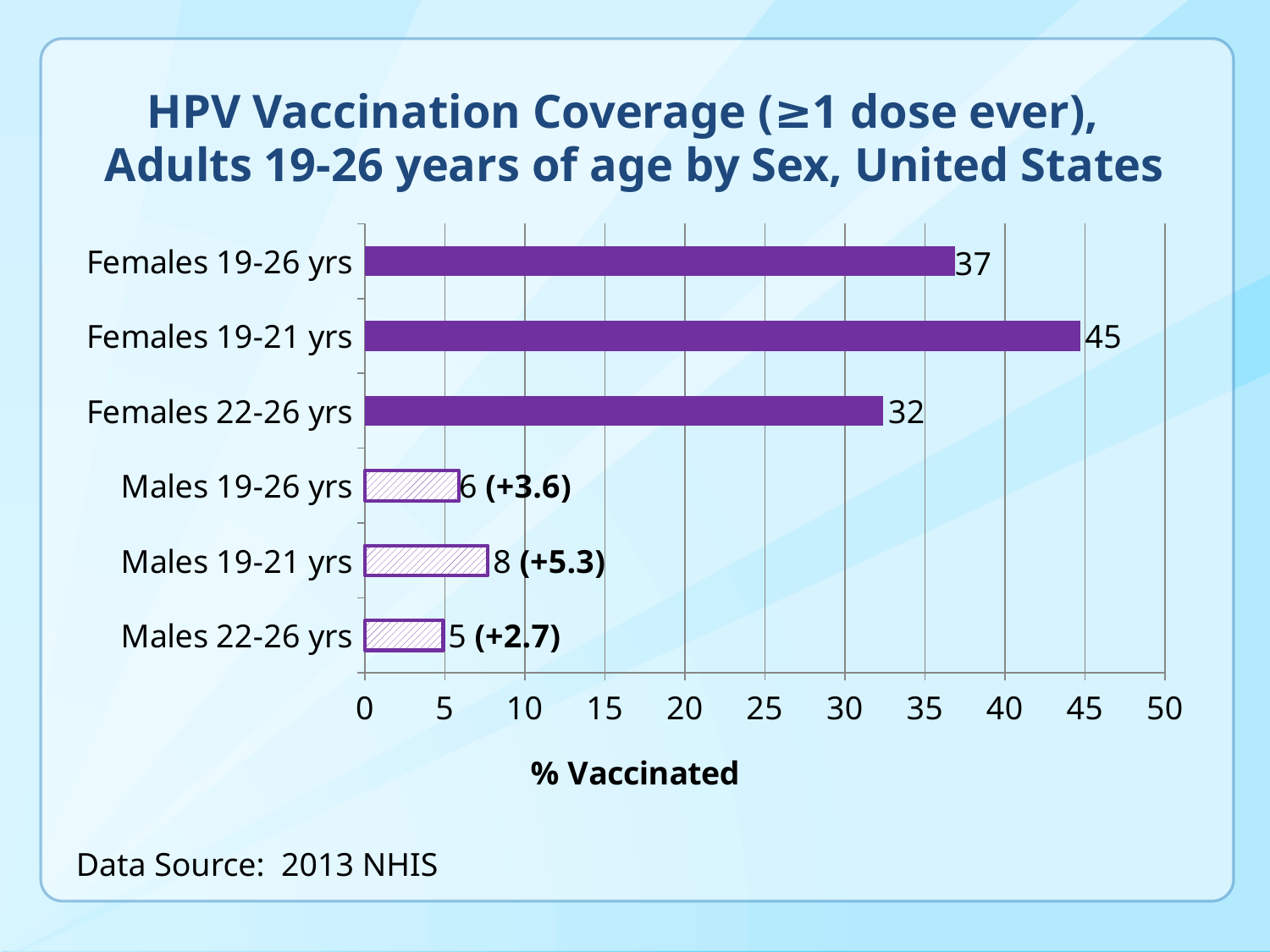
What kind of chart is shown on the slide? Bar chart What is the difference in % vaccinated between Females 19-26 yrs and Males 19-26 yrs? 31 Which has a higher % vaccinated, Males 19-21 yrs or Males 22-26 yrs? Males 19-21 yrs What is the difference in % vaccinated between Females 19-21 yrs and Females 22-26 yrs? 13 Is the value for Females 19-26 yrs greater or less than 35? greater Which category has the highest % vaccinated? Females 19-21 yrs What is the % vaccinated value for Females 19-26 yrs? 37 Which category has the lowest % vaccinated? Males 22-26 yrs How many categories are shown on the chart? 6 What is the % vaccinated value for Males 19-21 yrs? 8 What is the label of the horizontal axis? % Vaccinated What is the % vaccinated value for Females 22-26 yrs? 32